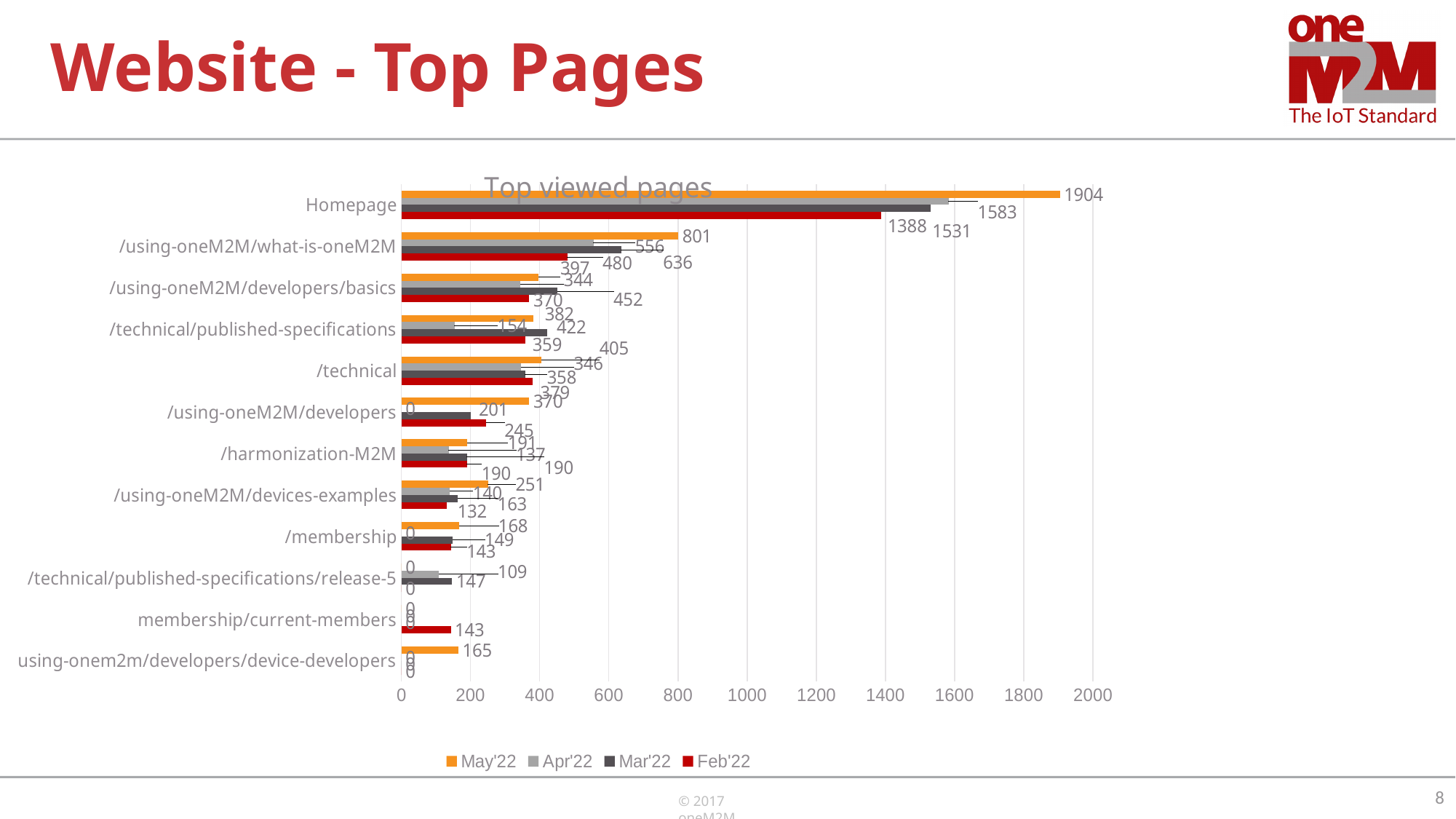
How many series does the legend list? 4 What is the title of the chart? Top viewed pages What is the Feb'22 value for Homepage? 1388 What is the May'22 value for Homepage? 1904 What type of chart is shown on the slide? bar chart Which page has the highest May'22 value? Homepage Which is larger for /using-oneM2M/what-is-oneM2M: the Mar'22 value or the Feb'22 value? Mar'22 What is the Feb'22 value for membership/current-members? 143 How many pages (categories) are listed on the chart? 12 What is the May'22 value for /using-oneM2M/what-is-oneM2M? 801 What is the May'22 value for using-onem2m/developers/device-developers? 165 What is the difference between the May'22 and Apr'22 values for Homepage? 321